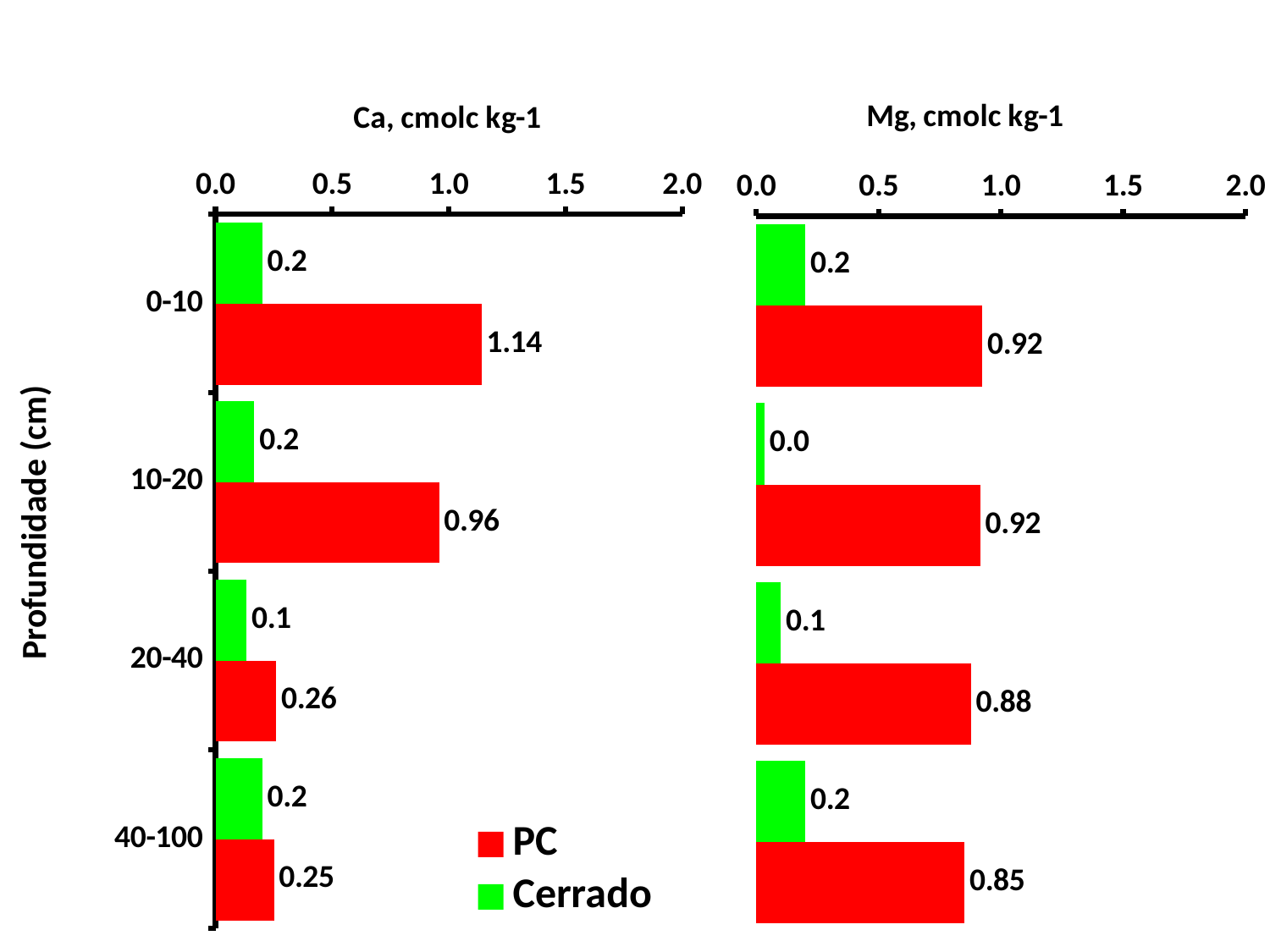
How many series does the legend list? 2 In the Mg chart, which is larger at depth 40-100 cm, PC or Cerrado? PC Which colour represents the Cerrado series in the legend? green In the Ca chart, at which depth is the PC value highest? 0-10 How many depth categories are shown in the Ca chart? 4 In the Ca chart, is the PC value at depth 0-10 cm greater or less than 1.0? greater In the Mg chart, what is the Cerrado value at depth 10-20 cm? 0.0 In the Ca chart, what is the PC value at depth 0-10 cm? 1.14 In the Ca chart, what is the difference between the PC and Cerrado values at depth 10-20 cm? 0.76 In the Mg chart, at which depth is the PC value lowest? 40-100 What type of chart is used for the Mg data? bar chart In the Mg chart, what is the PC value at depth 20-40 cm? 0.88